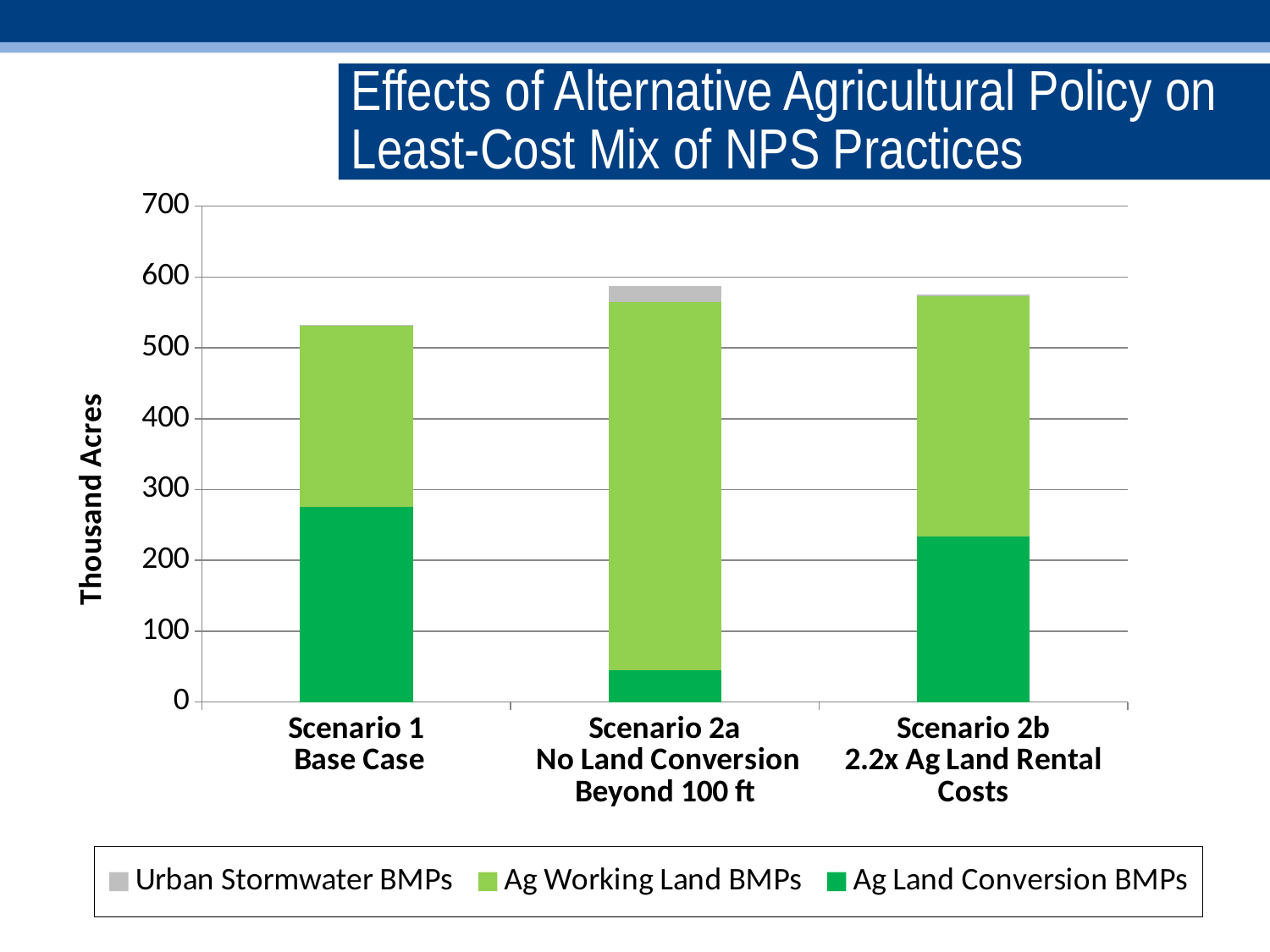
Is the total stacked bar for Scenario 2a greater or less than 600 thousand acres? less What kind of chart is shown on the slide? Stacked bar chart How many scenarios (categories) are shown on the x axis? 3 Is the Ag Land Conversion BMPs value for Scenario 2a greater or less than 100 thousand acres? less Is the Ag Land Conversion BMPs value for Scenario 1 Base Case greater or less than 200 thousand acres? greater How many series does the legend list? 3 Which scenario is the only one with a visible Urban Stormwater BMPs segment? Scenario 2a No Land Conversion Beyond 100 ft Which scenario has the lowest total stacked bar? Scenario 1 Base Case Which scenario has the largest Ag Land Conversion BMPs segment? Scenario 1 Base Case Which is larger: the Ag Working Land BMPs segment in Scenario 2a or in Scenario 1? Scenario 2a Which scenario has the smallest Ag Land Conversion BMPs segment? Scenario 2a No Land Conversion Beyond 100 ft